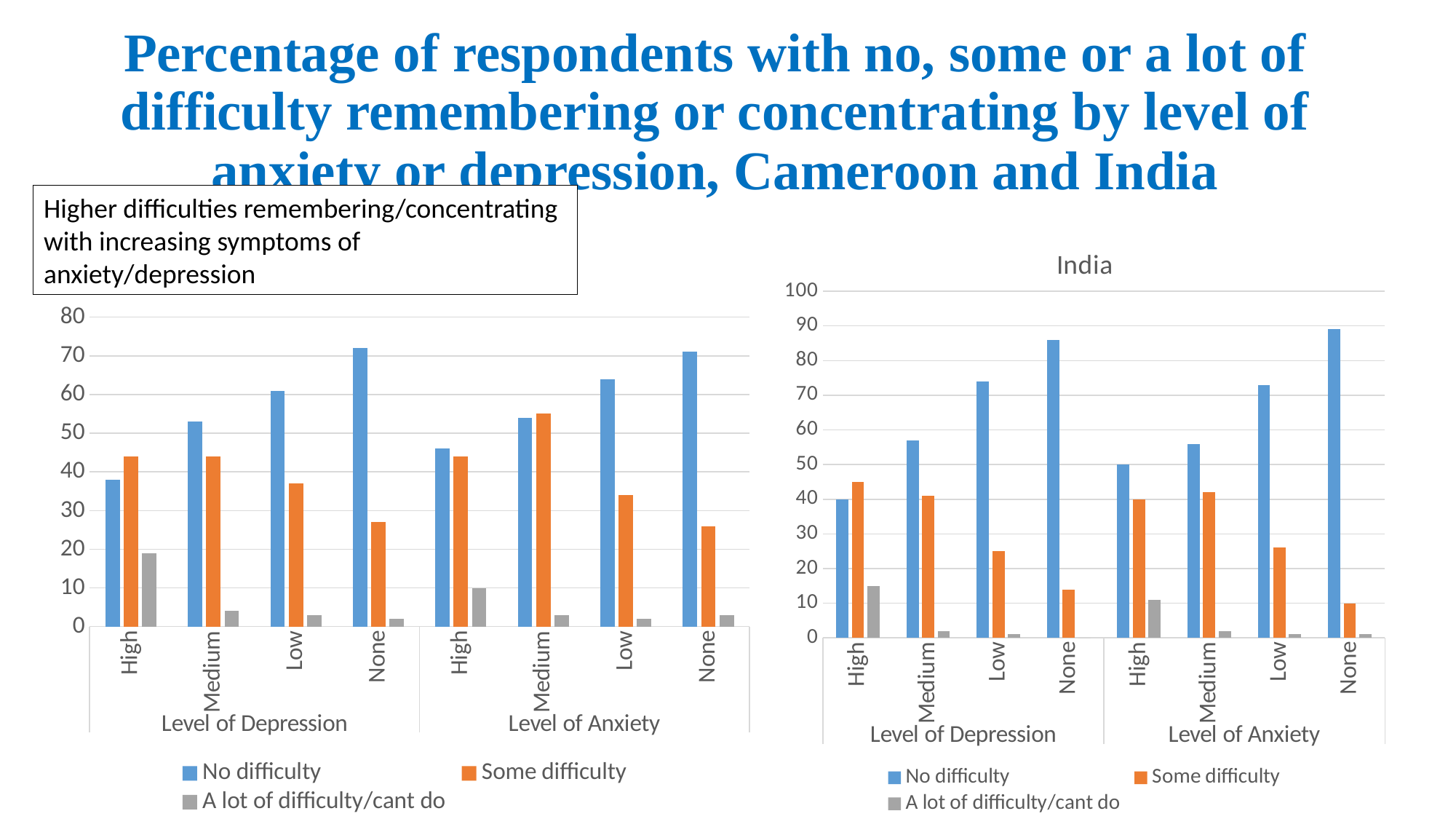
What kind of chart is the left chart? bar chart In the India chart, is the No difficulty value for None under Level of Depression greater or less than 80? greater How many category groups (bar clusters) are shown along the x axis of the left chart? 8 In the India chart, which category has the highest A lot of difficulty/cant do value? High under Level of Depression In the left chart, is the A lot of difficulty/cant do value for High under Level of Depression greater or less than 10? greater In the India chart, do the No difficulty values rise or fall going from High to None under Level of Depression? rise In the left chart, which category has the lowest No difficulty value? High under Level of Depression In the left chart, for High under Level of Depression, which is larger: No difficulty or Some difficulty? Some difficulty In the left chart, is the No difficulty value for High under Level of Depression greater or less than 50? less In the India chart, do the Some difficulty values rise or fall going from High to None under Level of Depression? fall What is the title of the right chart? India How many series does the legend of the India chart list? 3